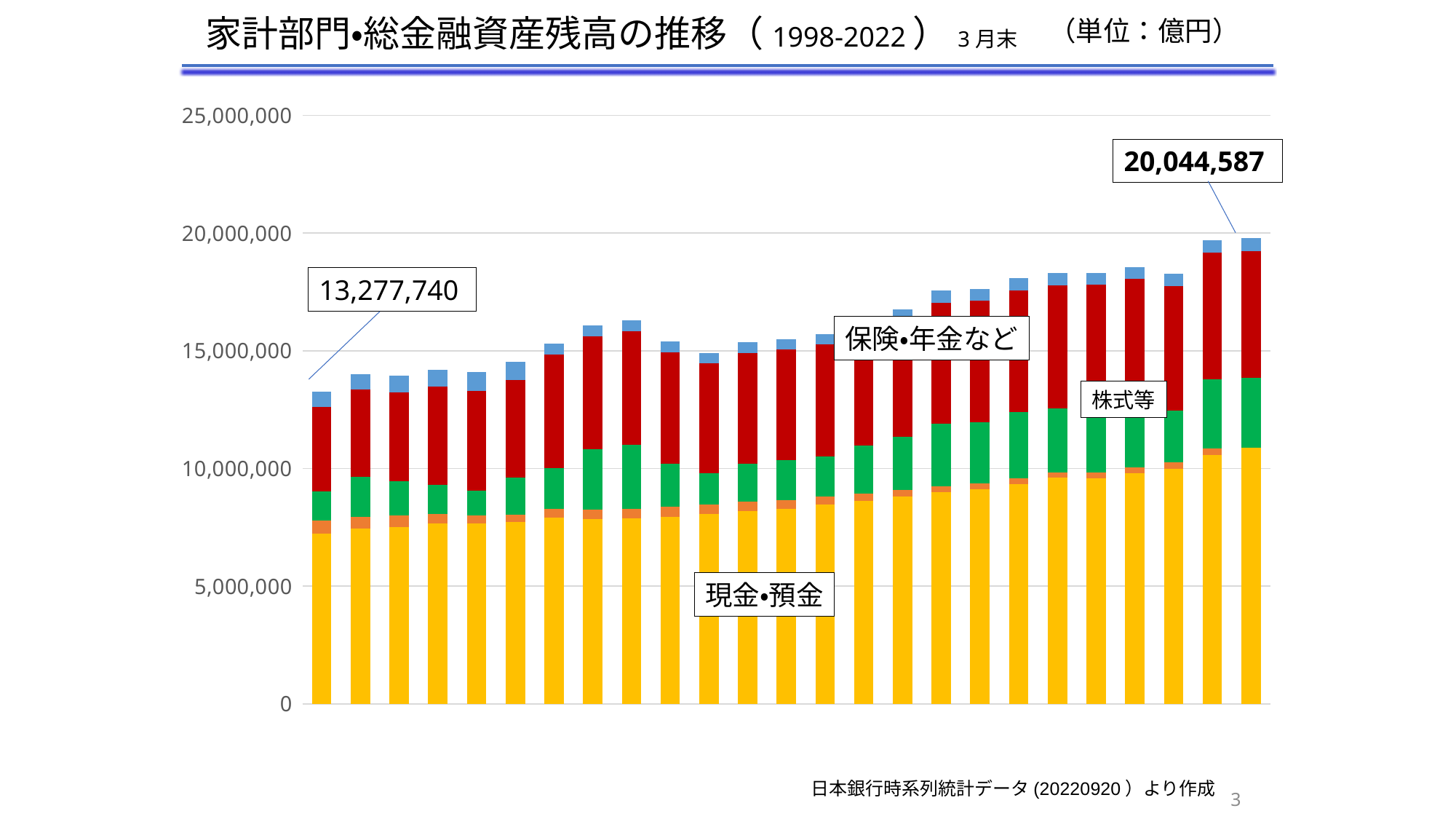
Is the 現金•預金 segment of the first (leftmost) bar greater or less than 10,000,000? less What is the difference between the labelled totals of the last bar (20,044,587) and the first bar (13,277,740)? 6,766,847 How many bars are plotted in the chart? 25 Do the bar totals generally rise or fall from left to right across the chart? Rise What unit is stated for the values in the chart? 億円 What is the total value labelled for the first (leftmost) bar? 13,277,740 Is the 現金•預金 segment of the last (rightmost) bar greater or less than 10,000,000? greater Which bar has the lowest total? The first (leftmost) bar, 13,277,740 Is the total of the first (leftmost) bar greater or less than 15,000,000? less Which is larger, the labelled total of the first bar or of the last bar? The last bar (20,044,587) What kind of chart is shown on the slide? Stacked bar chart What is the total value labelled for the last (rightmost) bar? 20,044,587